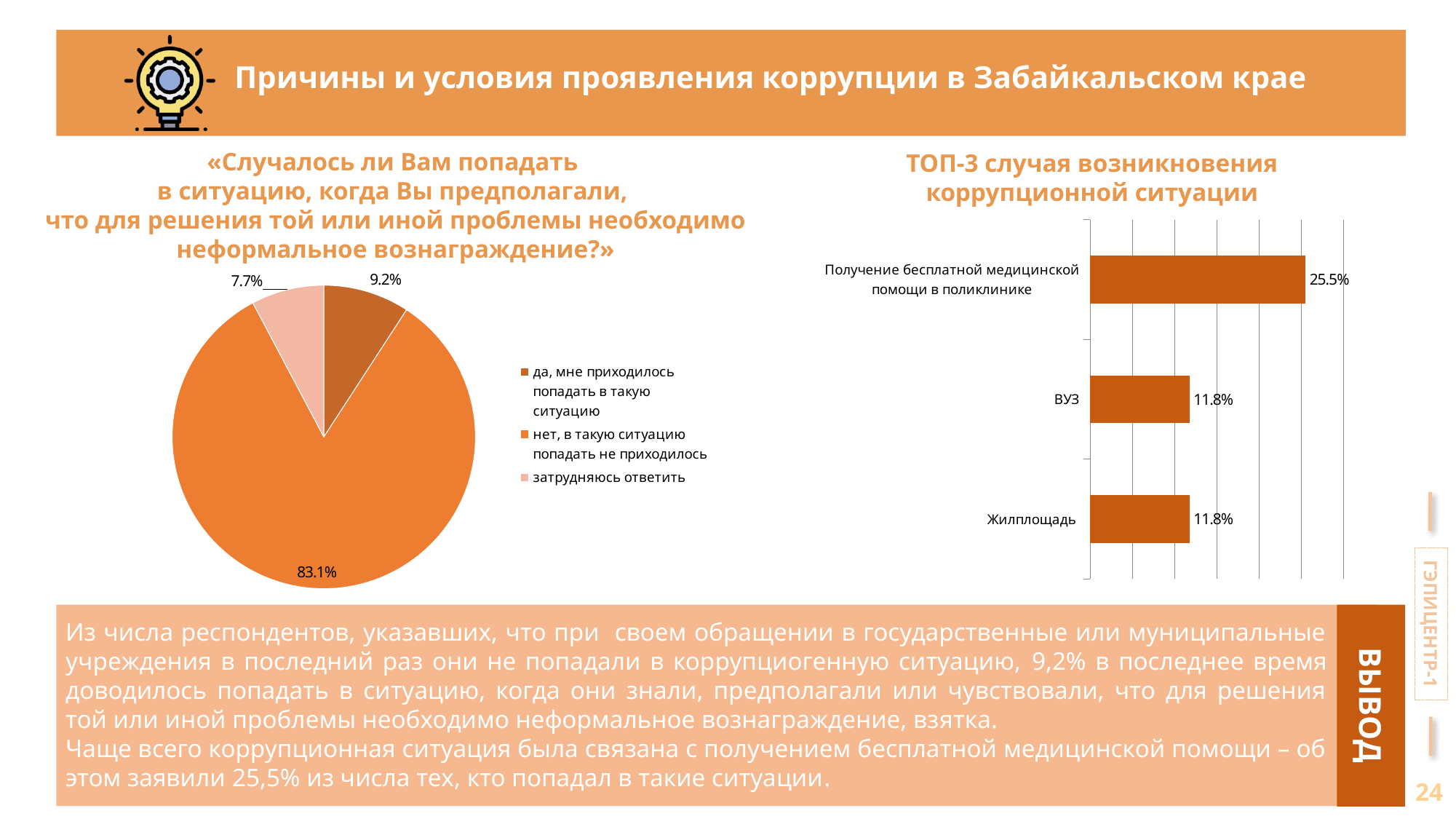
In the chart «ТОП-3 случая возникновения коррупционной ситуации», what is the value for «ВУЗ»? 11.8% In the chart «ТОП-3 случая возникновения коррупционной ситуации», what is the value for «Получение бесплатной медицинской помощи в поликлинике»? 25.5% In the pie chart on the left, which answer has the smallest slice? затрудняюсь ответить In the pie chart on the left, how many slices are there? 3 What type of chart is the chart on the left side of the slide? Pie chart In the chart «ТОП-3 случая возникновения коррупционной ситуации», which category has the highest value? Получение бесплатной медицинской помощи в поликлинике In the chart «ТОП-3 случая возникновения коррупционной ситуации», how many categories are shown? 3 In the pie chart on the left, what share of respondents answered «нет, в такую ситуацию попадать не приходилось»? 83.1% In the pie chart on the left, what share of respondents answered «да, мне приходилось попадать в такую ситуацию»? 9.2% In the pie chart on the left, what share of respondents answered «затрудняюсь ответить»? 7.7% In the chart «ТОП-3 случая возникновения коррупционной ситуации», what is the difference between the value for «Получение бесплатной медицинской помощи в поликлинике» and the value for «Жилплощадь»? 13.7 percentage points What type of chart is the chart «ТОП-3 случая возникновения коррупционной ситуации»? Bar chart